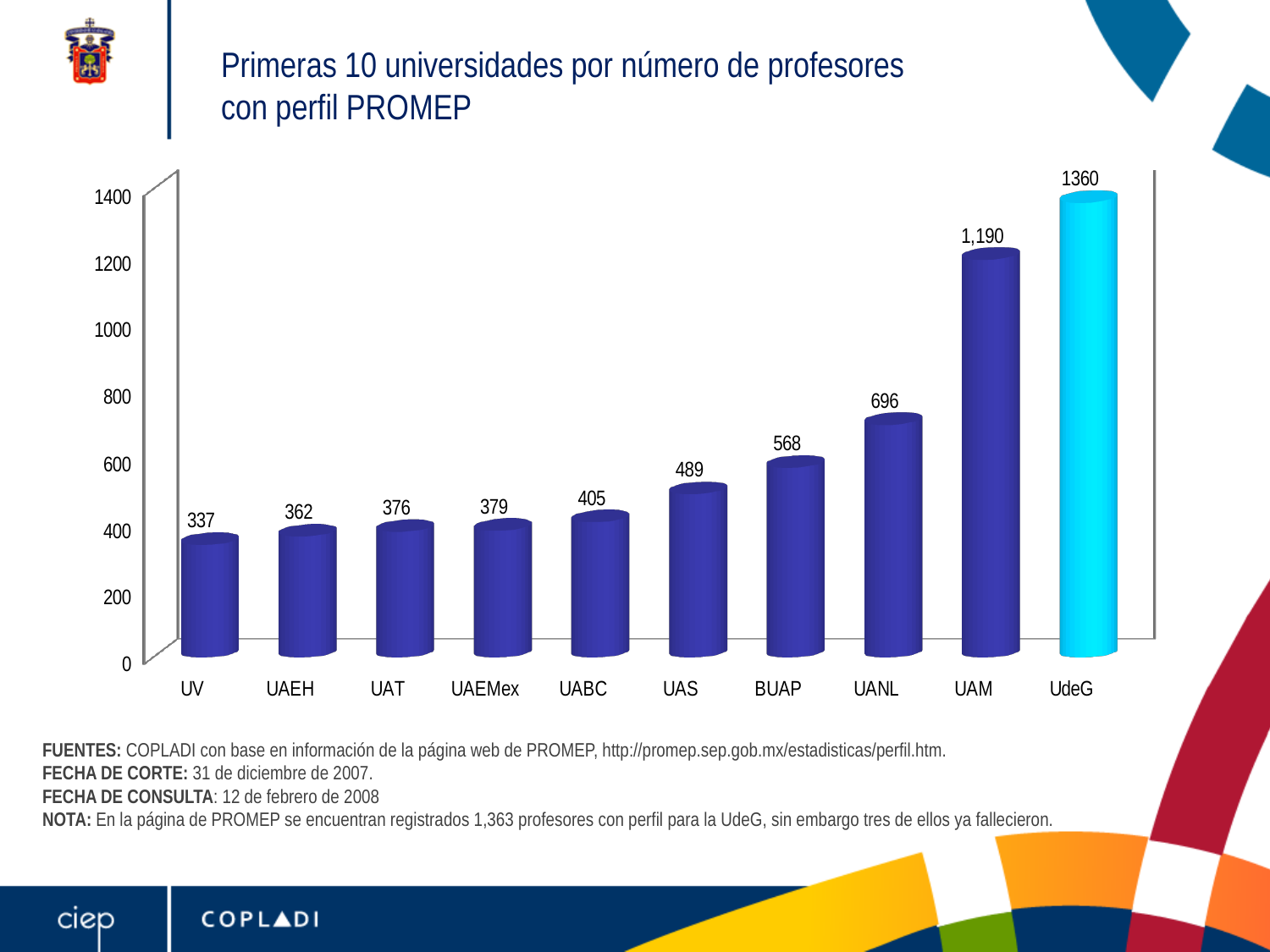
What kind of chart is shown on the slide? bar chart What is the value for UdeG? 1360 Which university has the highest number of professors with PROMEP profile? UdeG Which university has the lowest value on the chart? UV Which bar is shown in a different colour (light blue) from the others? UdeG Which is larger, the value for UAS or the value for UABC? UAS Do the values rise or fall from left to right along the x axis? rise What is the value for UAM? 1,190 What is the difference between the values for UANL and BUAP? 128 How many universities are shown on the chart? 10 What is the value for UAEMex? 379 Is the value for UANL greater or less than 600? greater